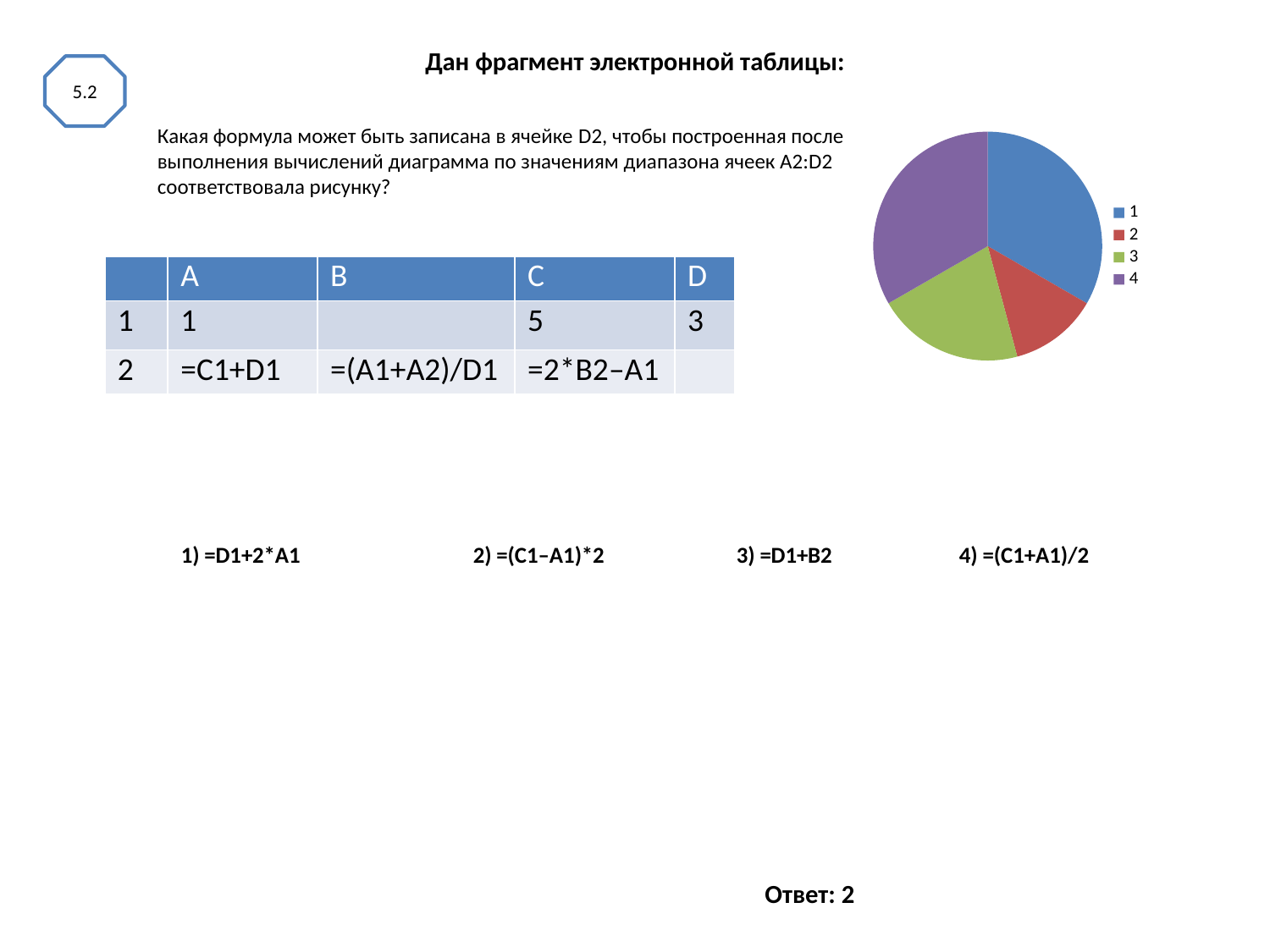
Which is larger in the pie chart, slice 1 or slice 2? 1 Which is larger in the pie chart, slice 4 or slice 3? 4 What are the legend entries of the pie chart? 1, 2, 3, 4 Which slice of the pie chart is the smallest? 2 Which is larger in the pie chart, slice 1 or slice 3? 1 What kind of chart is shown on the slide? pie chart How many slices does the pie chart have? 4 What colour is slice 1 in the pie chart? blue How many entries does the legend of the pie chart list? 4